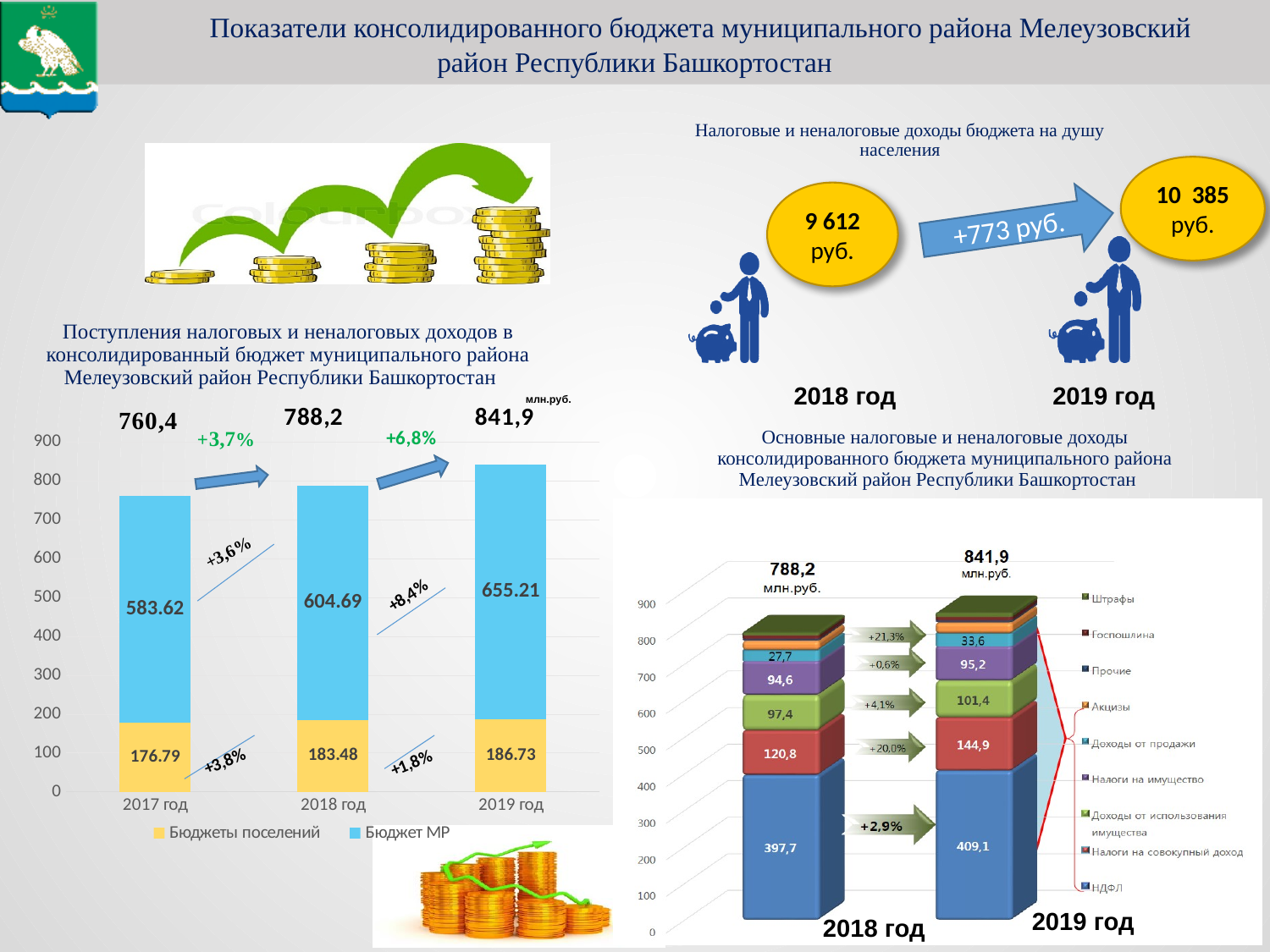
In the right chart (Основные налоговые и неналоговые доходы), what is the value of the bottom (НДФЛ) segment for 2019 год? 409,1 In the left chart (Поступления налоговых и неналоговых доходов), what is the total shown above the bar for 2018 год? 788,2 In the left chart (Поступления налоговых и неналоговых доходов), what is the value for Бюджет МР in 2019 год? 655.21 In the left chart (Поступления налоговых и неналоговых доходов), what is the value for Бюджеты поселений in 2017 год? 176.79 In the right chart (Основные налоговые и неналоговые доходы), what is the total shown above the bar for 2019 год? 841,9 In the left chart (Поступления налоговых и неналоговых доходов), which year has the highest value for Бюджет МР? 2019 год In the left chart (Поступления налоговых и неналоговых доходов), what is the difference between the Бюджет МР values for 2018 год and 2017 год? 21.07 In the right chart (Основные налоговые и неналоговые доходы), how many series does the legend list? 9 In the left chart (Поступления налоговых и неналоговых доходов), do the Бюджет МР values rise or fall from 2017 год to 2019 год? rise In the left chart (Поступления налоговых и неналоговых доходов), which year has the lowest value for Бюджеты поселений? 2017 год What kind of chart is the left chart (Поступления налоговых и неналоговых доходов)? stacked bar chart In the left chart (Поступления налоговых и неналоговых доходов), how many series does the legend list? 2